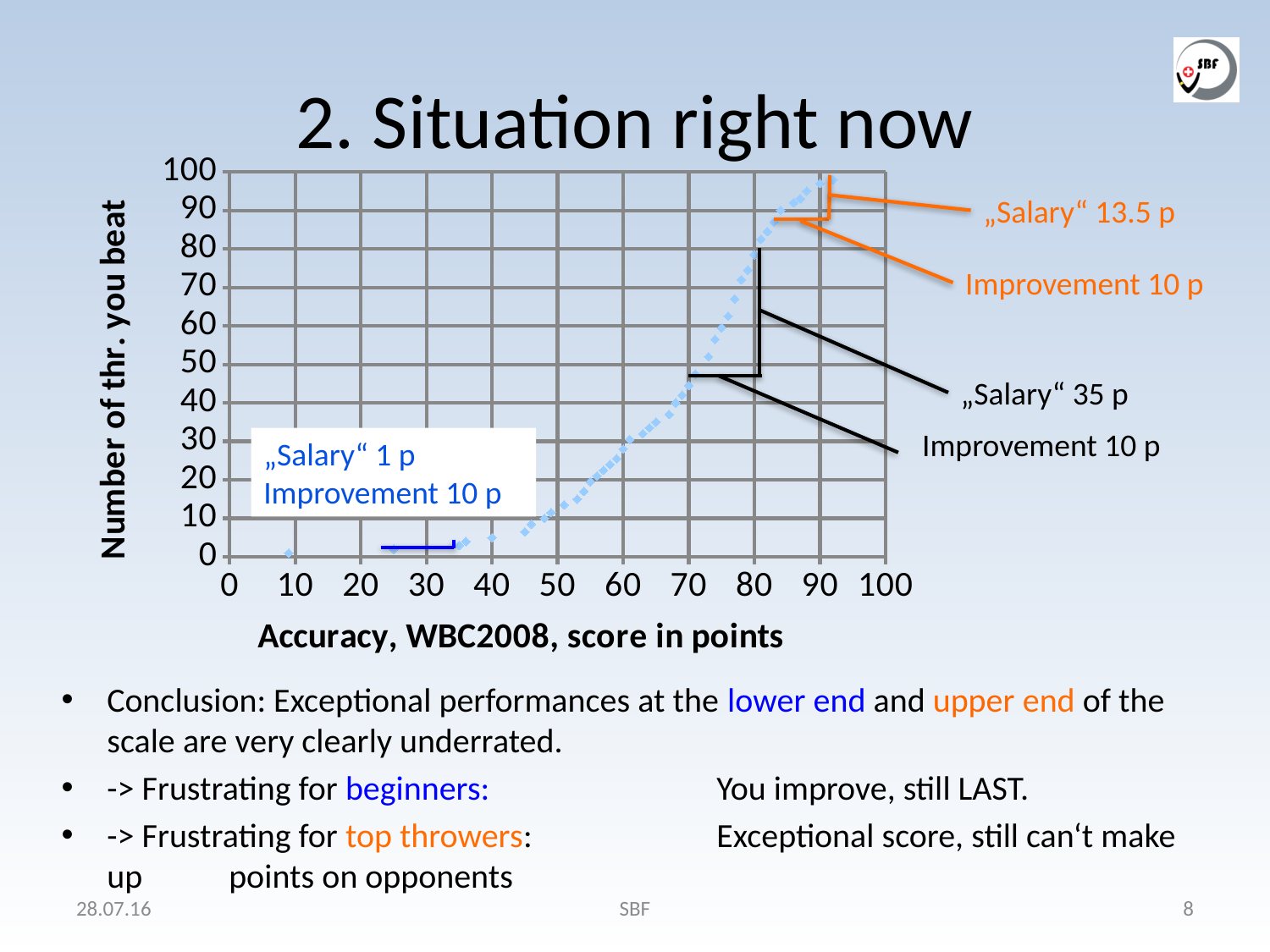
According to the annotation at the lower end of the curve, what is the "Salary" for an improvement of 10 p? 1 p What is the title of the y axis of the chart? Number of thr. you beat What is the title of the x axis of the chart? Accuracy, WBC2008, score in points According to the annotation in the middle of the curve, what is the "Salary" for an improvement of 10 p? 35 p Is the number of throwers you beat at an accuracy score of 50 greater or less than 20? less Is the number of throwers you beat at an accuracy score of 90 greater or less than 90? greater What is the highest value shown on the y axis of the chart? 100 Do the plotted values rise or fall as the accuracy score increases along the x axis? rise Is the number of throwers you beat at an accuracy score of 30 greater or less than 10? less According to the annotation at the upper end of the curve, what is the "Salary" for an improvement of 10 p? 13.5 p